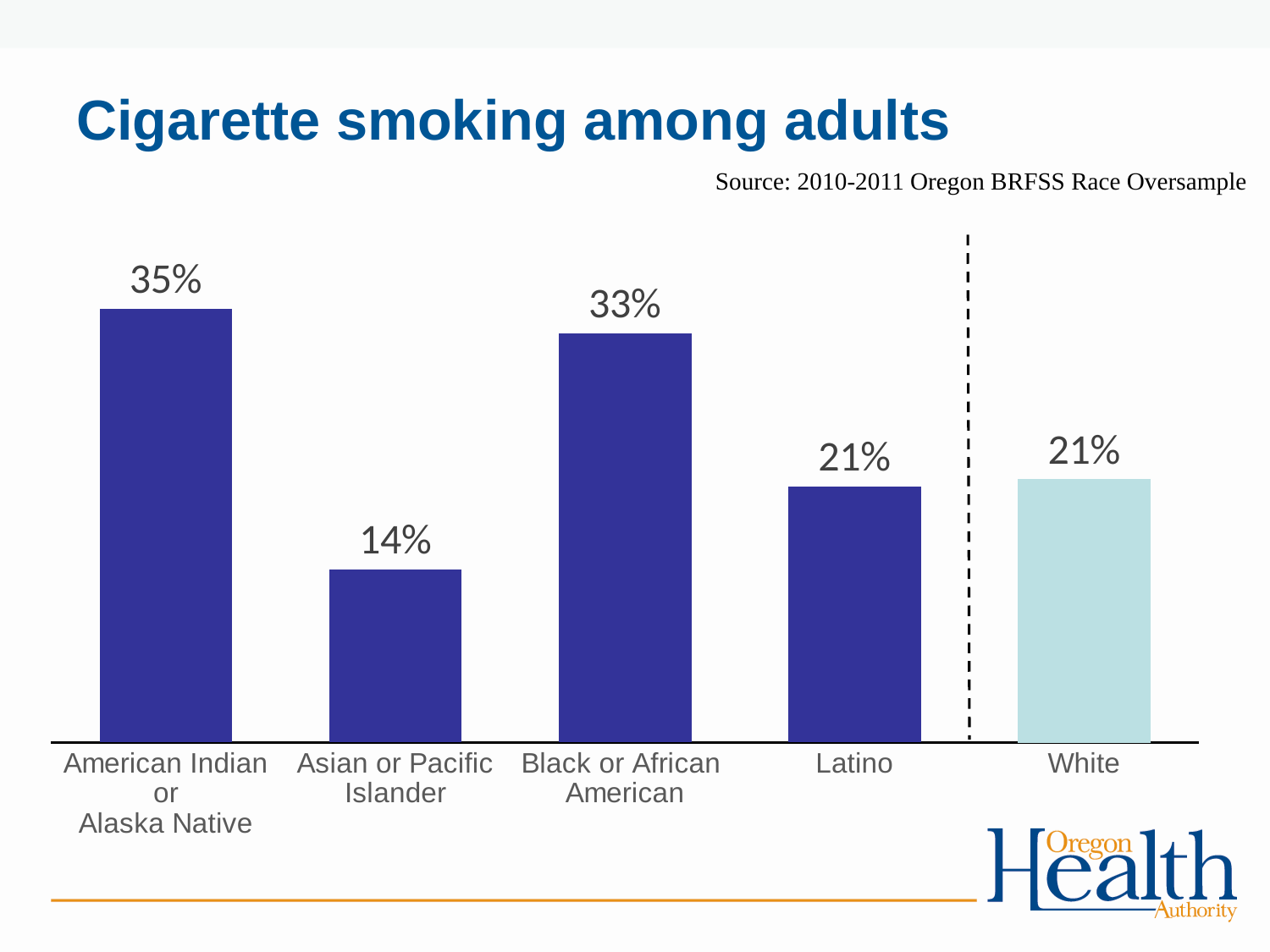
What is the difference in smoking rate between American Indian or Alaska Native adults and Asian or Pacific Islander adults? 21 percentage points Which group has the highest cigarette smoking rate? American Indian or Alaska Native What is the title of the chart? Cigarette smoking among adults How many racial or ethnic groups are shown in the chart? 5 What type of chart is shown on the slide? Bar chart What is the cigarette smoking rate for Black or African American adults? 33% What is the cigarette smoking rate for White adults? 21% Which group has the lowest cigarette smoking rate? Asian or Pacific Islander Which group has a higher smoking rate, Black or African American or Latino? Black or African American What is the cigarette smoking rate for Asian or Pacific Islander adults? 14% What is the difference in smoking rate between Black or African American adults and Latino adults? 12 percentage points What is the cigarette smoking rate for American Indian or Alaska Native adults? 35%